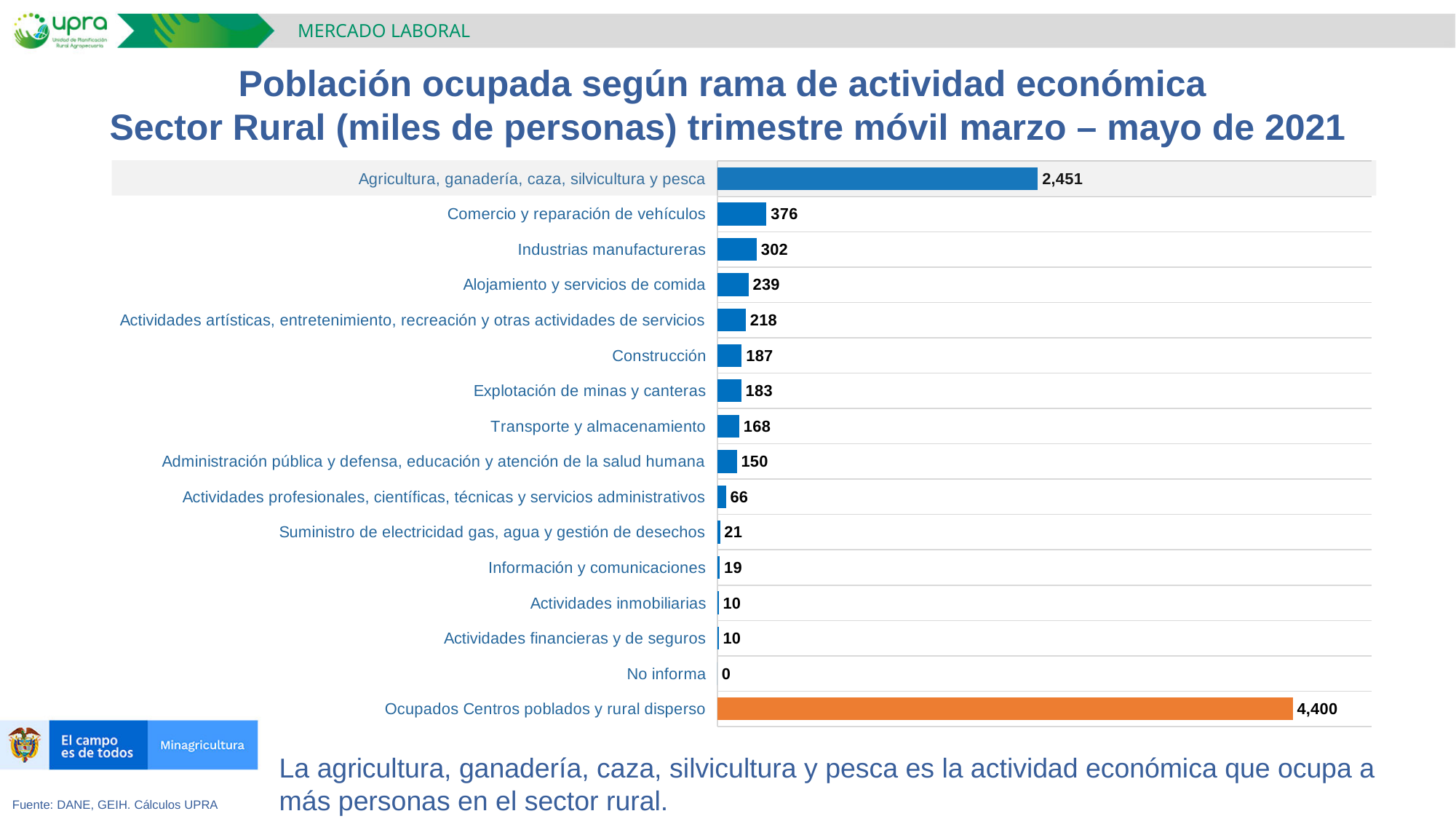
What is the difference between the values for Agricultura, ganadería, caza, silvicultura y pesca and Alojamiento y servicios de comida? 2,212 What is the value for Ocupados Centros poblados y rural disperso? 4,400 What kind of chart is shown on the slide? Bar chart How many categories are shown on the chart? 16 Which category has the lowest value on the chart? No informa What is the difference between the values for Comercio y reparación de vehículos and Industrias manufactureras? 74 Which category has the highest value on the chart? Ocupados Centros poblados y rural disperso What is the value for Construcción? 187 Which is larger, the value for Transporte y almacenamiento or the value for Explotación de minas y canteras? Explotación de minas y canteras What is the value for Comercio y reparación de vehículos? 376 What is the value for Agricultura, ganadería, caza, silvicultura y pesca? 2,451 Which bar is shown in orange rather than blue? Ocupados Centros poblados y rural disperso